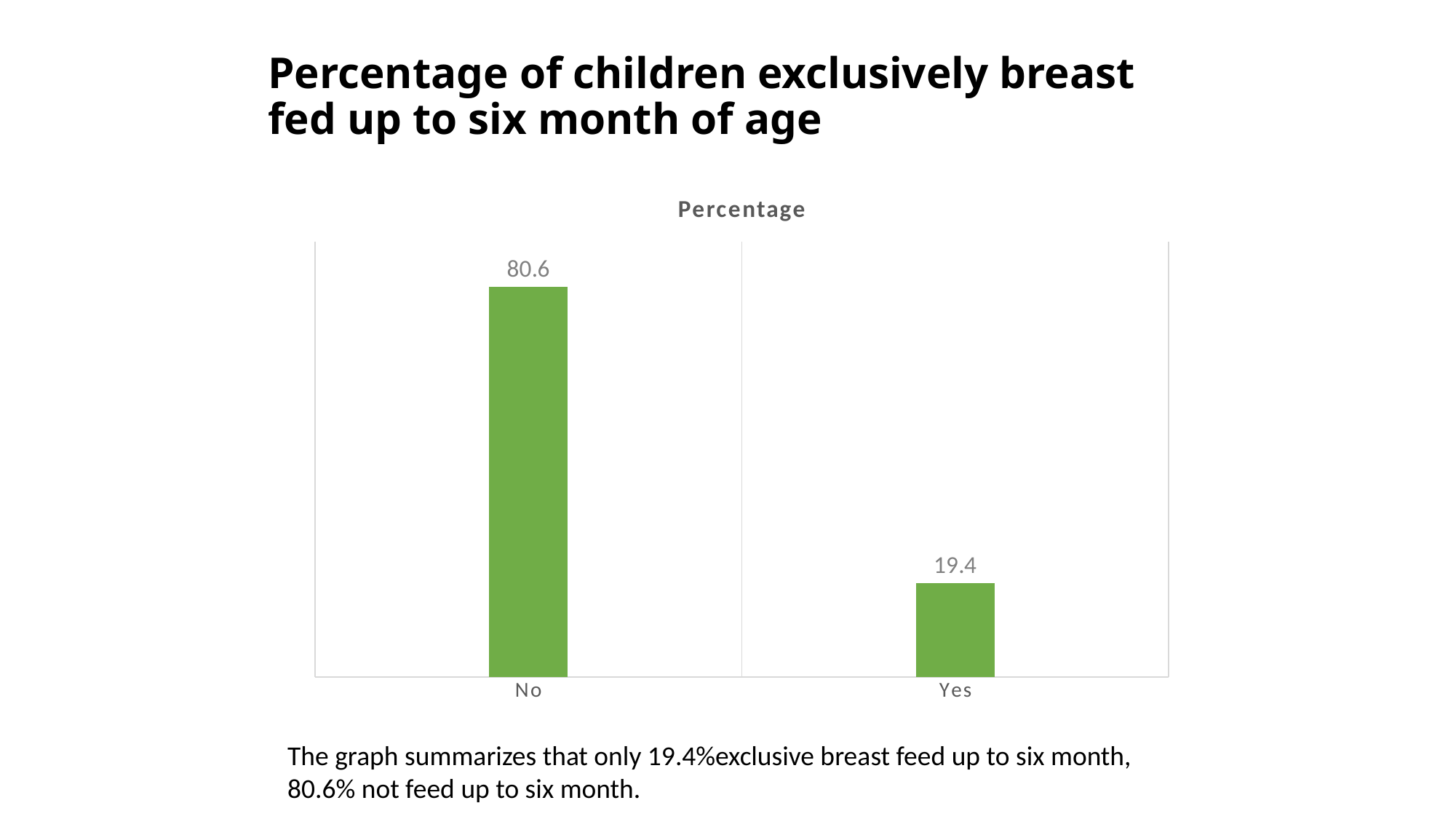
What is the title shown above the chart's plot area? Percentage What colour are the bars in the chart? Green What is the value for the "No" category? 80.6 Which category has the highest value? No What is the difference between the values for "No" and "Yes"? 61.2 Which category has the lowest value? Yes What is the value for the "Yes" category? 19.4 What kind of chart is shown on the slide? Bar chart How many categories are shown on the x axis? 2 Which is larger, the value for "No" or the value for "Yes"? No What is the total of the two bar values? 100